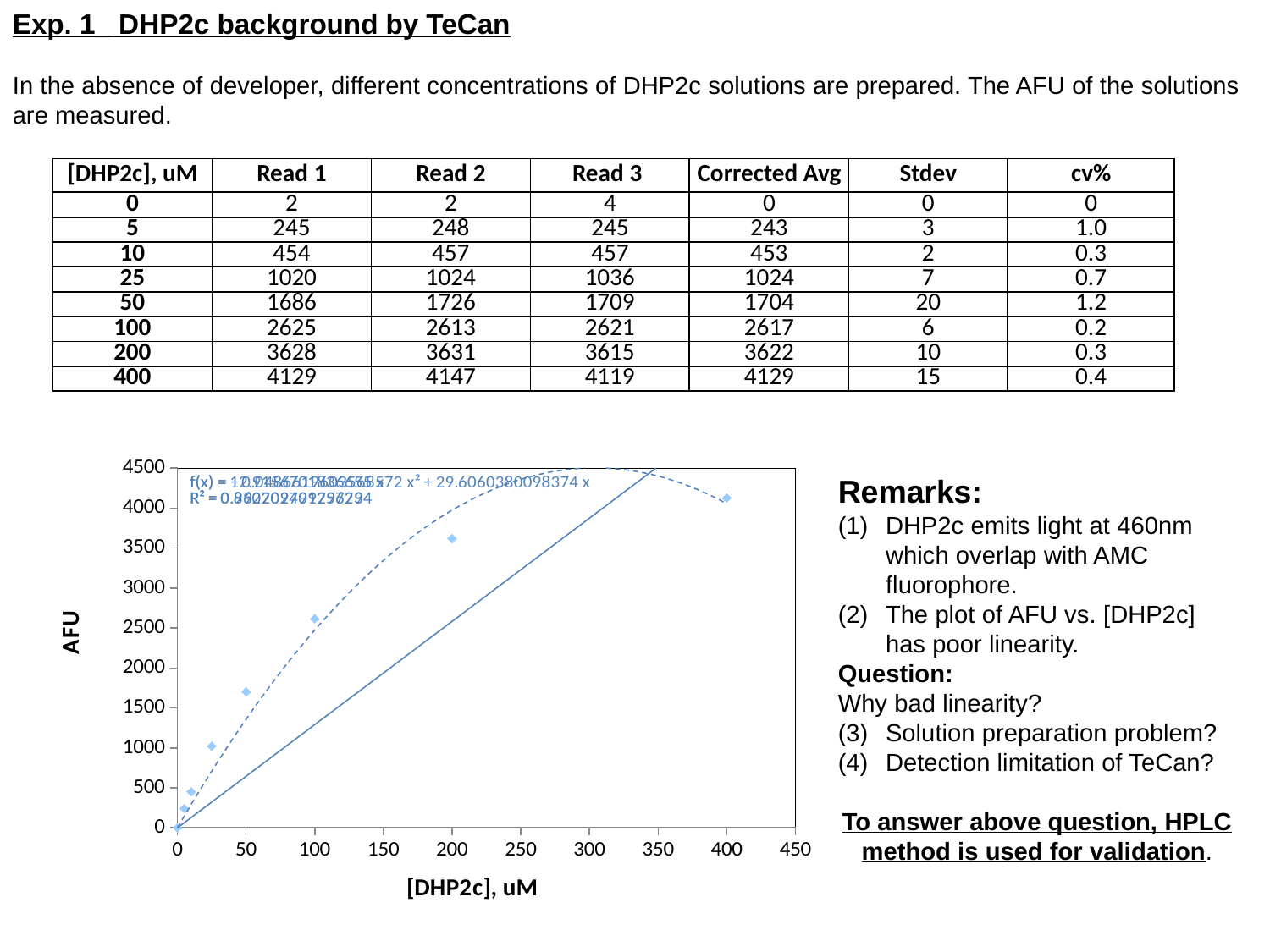
What kind of chart is shown on the slide? scatter chart Is the plotted AFU value at 50 uM greater or less than 2000? less What is the label of the y axis of the chart? AFU Does the AFU value rise or fall as [DHP2c] increases along the x axis? rise How many data points are plotted in the AFU vs. [DHP2c] chart? 8 What is the highest tick value shown on the y axis of the chart? 4500 What is the label of the x axis of the chart? [DHP2c], uM Is the plotted AFU value at 400 uM greater or less than 4000? greater Which has the larger plotted AFU value: 100 uM or 200 uM? 200 uM Is the plotted AFU value at 25 uM greater or less than 1500? less At which [DHP2c] concentration is the plotted AFU highest? 400